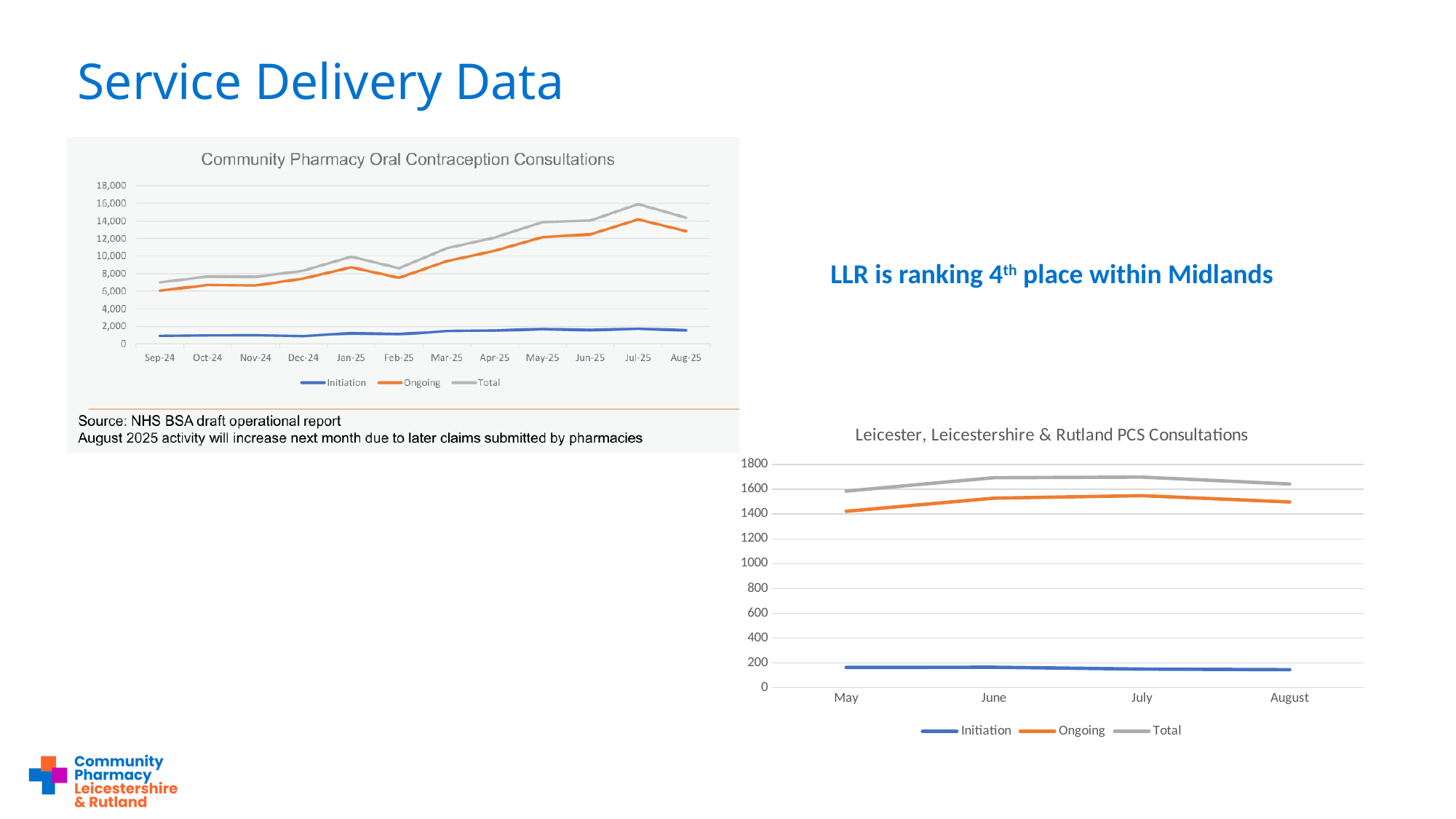
What kind of chart is the 'Community Pharmacy Oral Contraception Consultations' chart? line chart In the 'Community Pharmacy Oral Contraception Consultations' chart, which series has the lowest values throughout the period? Initiation What kind of chart is the 'Leicester, Leicestershire & Rutland PCS Consultations' chart? line chart In the 'Leicester, Leicestershire & Rutland PCS Consultations' chart, is the Total value for June greater or less than 1600? greater In the 'Leicester, Leicestershire & Rutland PCS Consultations' chart, is the Initiation value for May greater or less than 200? less How many months are plotted on the x axis of the 'Leicester, Leicestershire & Rutland PCS Consultations' chart? 4 How many months are plotted on the x axis of the 'Community Pharmacy Oral Contraception Consultations' chart? 12 In the 'Community Pharmacy Oral Contraception Consultations' chart, is the Total value for Jul-25 greater or less than 14,000? greater In the 'Community Pharmacy Oral Contraception Consultations' chart, does the Ongoing series generally rise or fall from Sep-24 to Jul-25? rise How many series does the legend of the 'Community Pharmacy Oral Contraception Consultations' chart list? 3 In the 'Community Pharmacy Oral Contraception Consultations' chart, in which month does the Total series reach its highest value? Jul-25